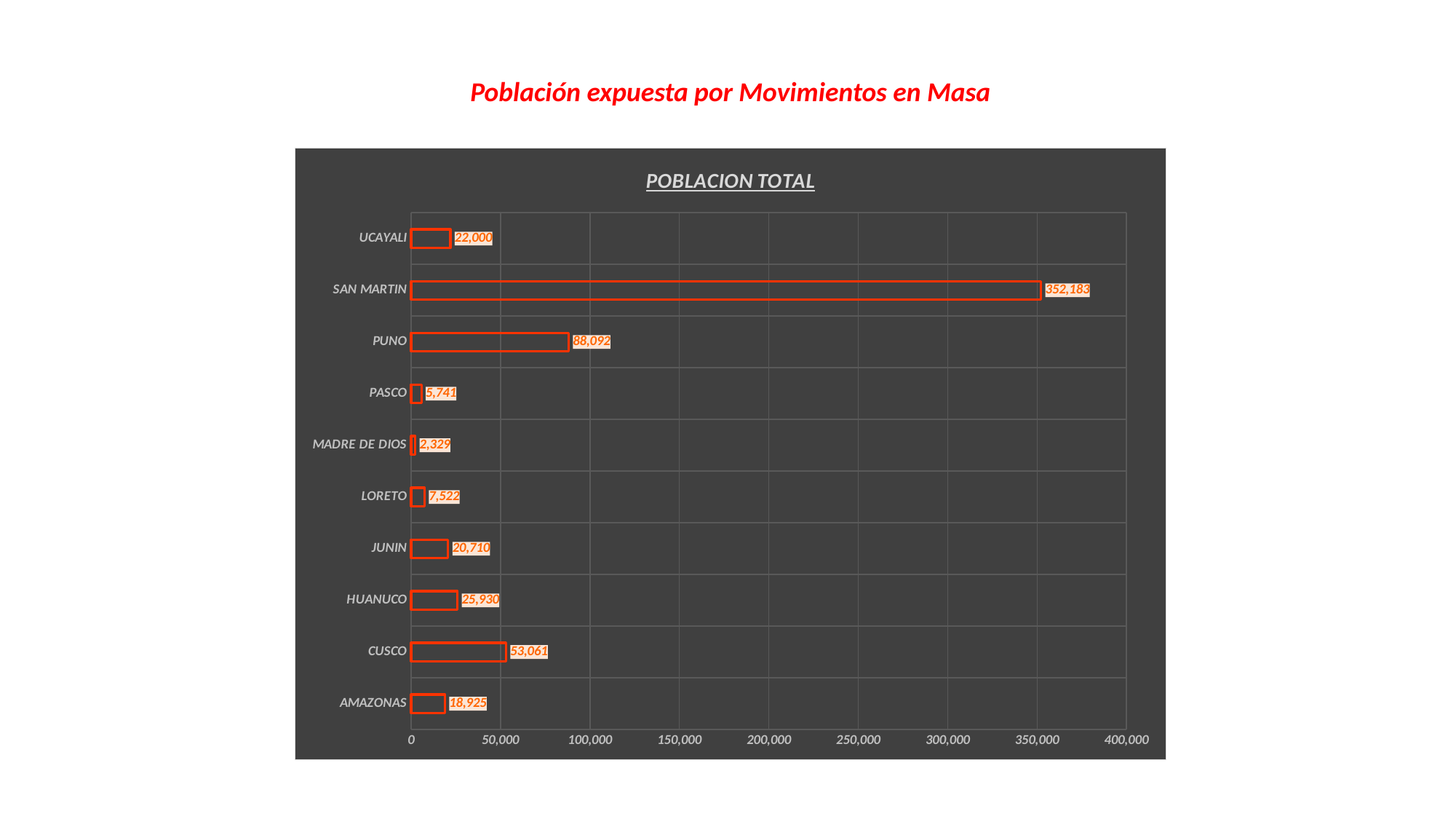
How many categories are shown in the chart? 10 What is the value for PUNO? 88,092 Which category has the lowest value? MADRE DE DIOS Which category has the highest value? SAN MARTIN Is the value for PUNO greater or less than 100,000? less Which is larger, the value for UCAYALI or the value for JUNIN? UCAYALI What is the value for MADRE DE DIOS? 2,329 What is the value for HUANUCO? 25,930 What is the title shown inside the chart area? POBLACION TOTAL What is the value for SAN MARTIN? 352,183 What kind of chart is shown? bar chart What is the difference between the values for CUSCO and AMAZONAS? 34,136